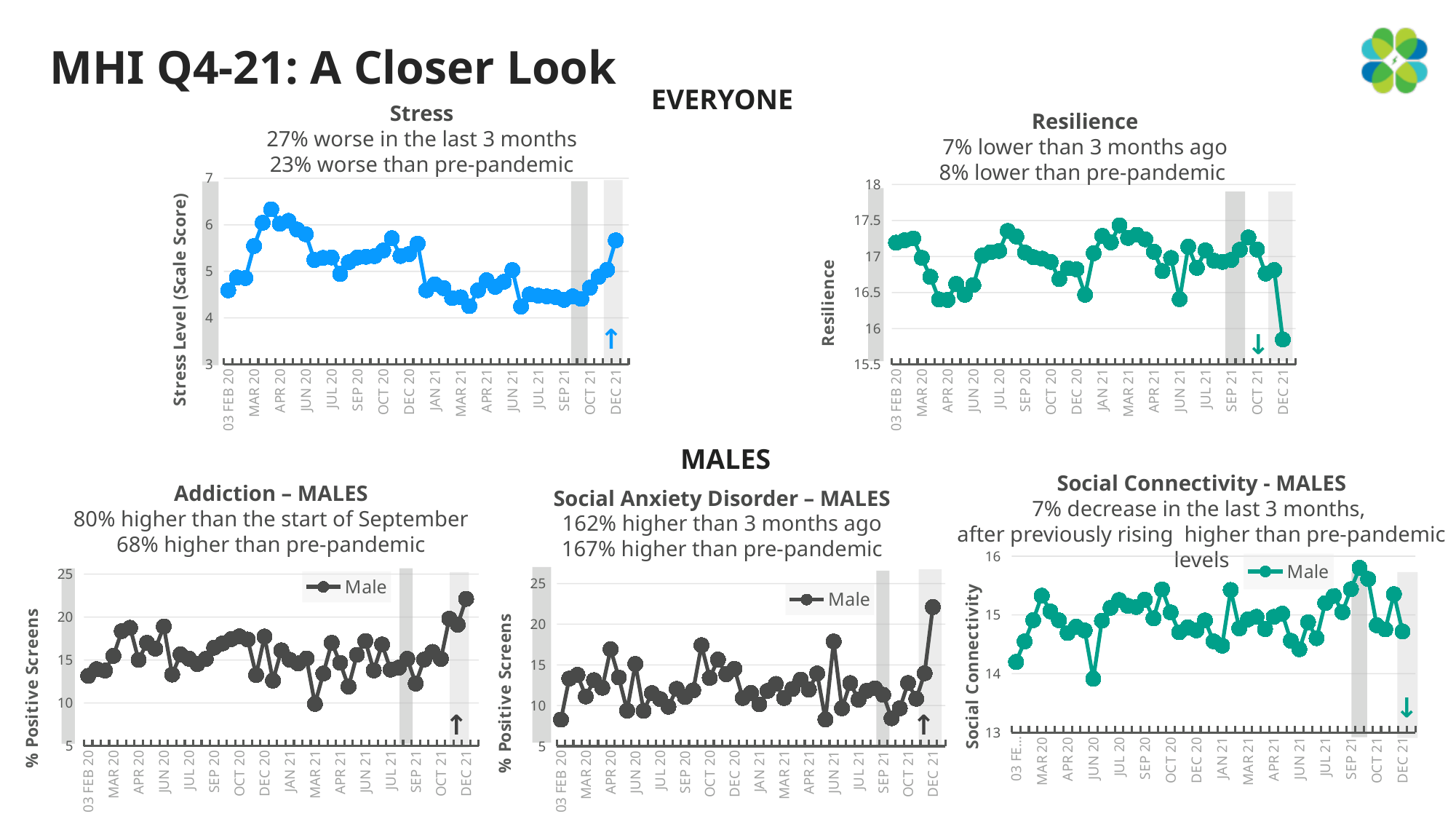
How many charts are shown on the slide? 5 In the Stress chart, is the value for DEC 21 greater or less than 5? greater In the Addiction – MALES chart, is the value for DEC 21 greater or less than 20? greater In the Social Connectivity - MALES chart, is the peak value around SEP 21 greater or less than 15.5? greater In the Resilience chart, do the values rise or fall between OCT 21 and DEC 21? fall How many series does the legend of the Addiction – MALES chart list? 1 What kind of chart is the Stress chart? line chart In the Stress chart, do the values rise or fall between SEP 21 and DEC 21? rise According to the Stress chart subtitle, by how much is stress worse than pre-pandemic? 23% worse What series name appears in the legend of the Social Anxiety Disorder – MALES chart? Male